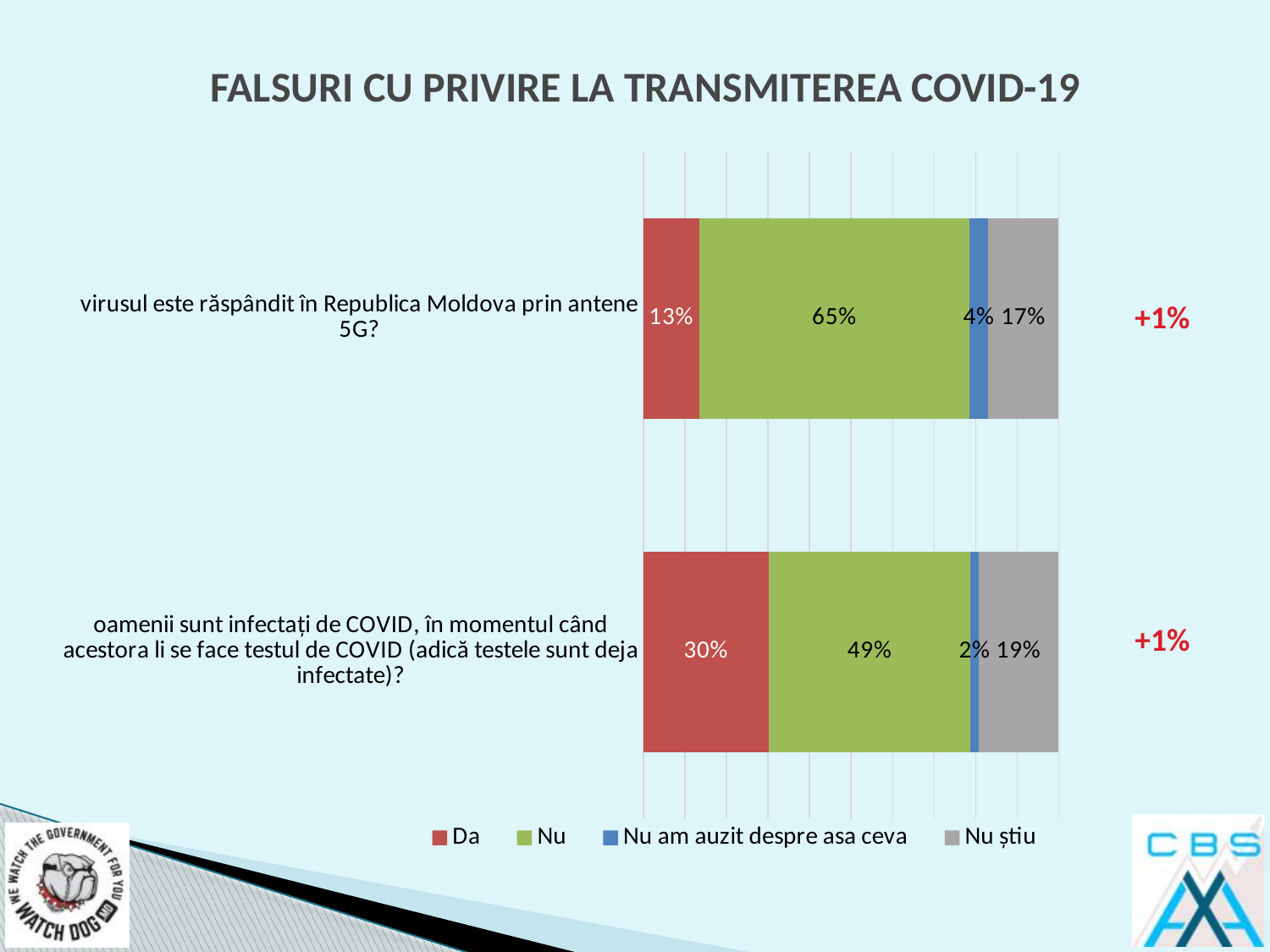
What is the difference between the "Da" values for the two questions (30% vs 13%)? 17% How many categories (questions) are plotted in the chart? 2 Which series has the lowest value for the question about people being infected when they take the COVID test? Nu am auzit despre asa ceva What is the total of the stacked bar for the question about people being infected when they take the COVID test? 100% What is the value of "Nu știu" for the question about people being infected when they take the COVID test? 19% How many series does the legend list? 4 What kind of chart is shown on the slide? stacked bar chart Which question has the larger "Nu" value: the one about 5G antennas or the one about infected tests? the one about 5G antennas What is the value of "Nu" for the question about the virus being spread through 5G antennas? 65% What is the value of "Nu am auzit despre asa ceva" for the question about people being infected when they take the COVID test? 2% What is the value of "Da" for the question about the virus being spread through 5G antennas? 13% Which series has the highest value for the question about the virus being spread through 5G antennas? Nu